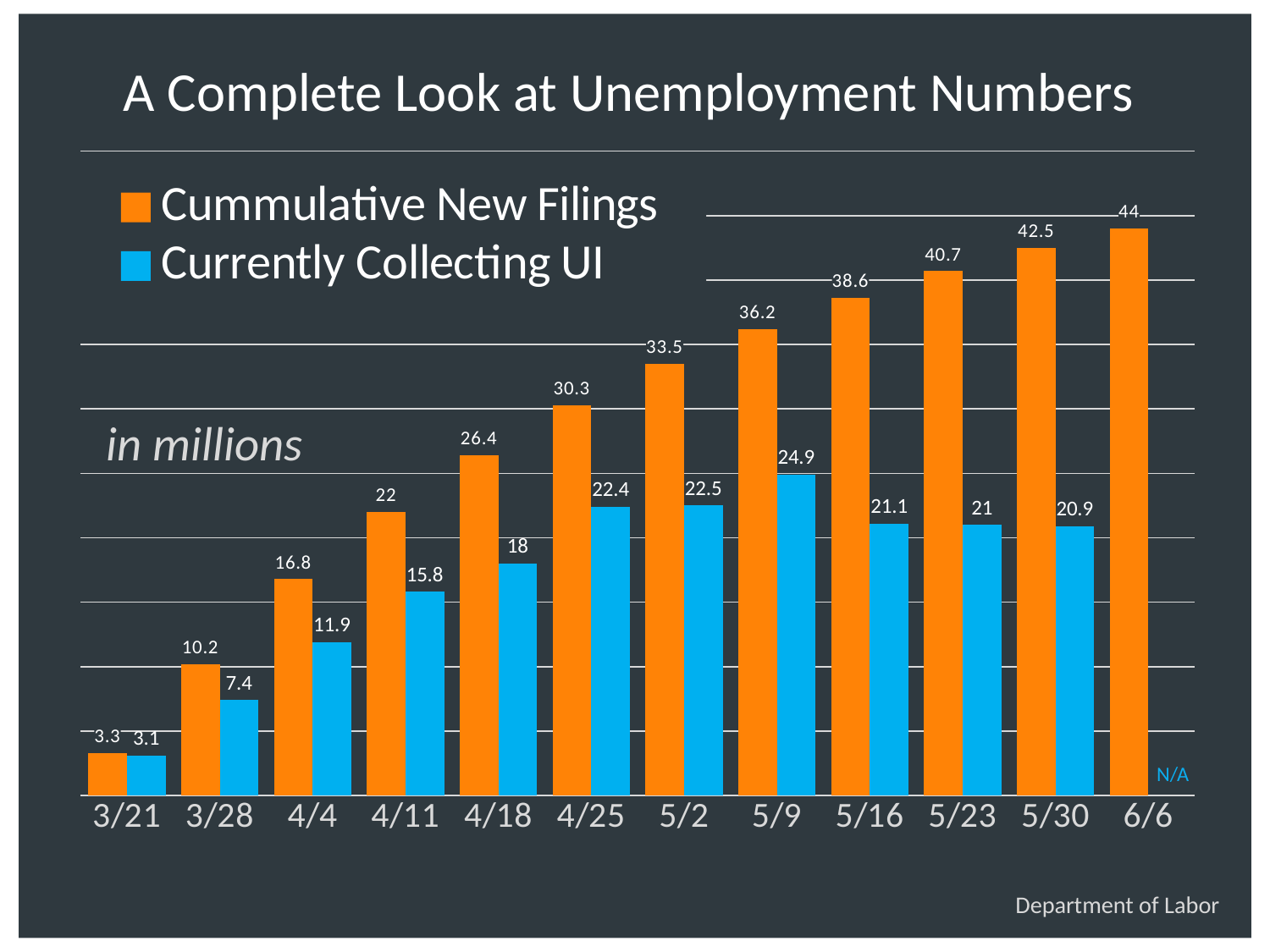
What is the value for Currently Collecting UI on 6/6? N/A On which date is Cummulative New Filings lowest? 3/21 What is the value for Currently Collecting UI on 4/18? 18 On which date is Currently Collecting UI highest? 5/9 What is the difference between Cummulative New Filings and Currently Collecting UI on 5/30? 21.6 What unit are the values in, according to the label on the chart? in millions How many series does the legend list? 2 What is the value for Cummulative New Filings on 5/9? 36.2 How many dates are shown on the x axis? 12 Which is larger on 4/25: Cummulative New Filings or Currently Collecting UI? Cummulative New Filings Do the Cummulative New Filings values rise or fall from 3/21 to 6/6? Rise What kind of chart is shown? Bar chart